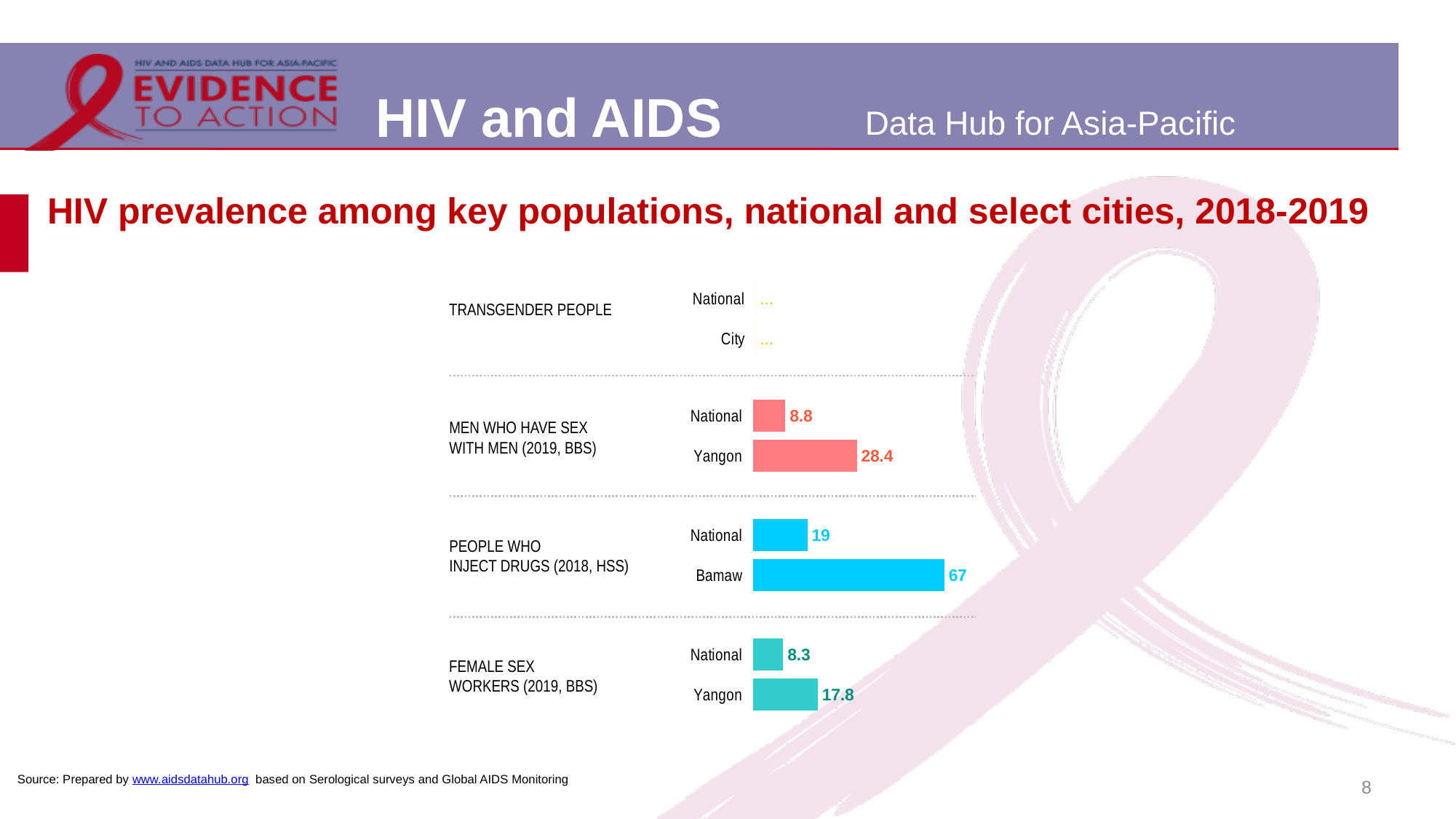
Which bar shows the highest HIV prevalence on the chart? People who inject drugs, Bamaw What is the national HIV prevalence among female sex workers (2019, BBS)? 8.3 What is the HIV prevalence among female sex workers in Yangon? 17.8 What kind of chart is shown on the slide? Bar chart What values are shown for transgender people (national and city)? ... (no data) What is the national HIV prevalence among men who have sex with men (2019, BBS)? 8.8 What is the HIV prevalence among men who have sex with men in Yangon? 28.4 What is the HIV prevalence among people who inject drugs in Bamaw? 67 What is the difference between the Bamaw and national HIV prevalence among people who inject drugs? 48 Which is larger: the Yangon value for men who have sex with men or the Yangon value for female sex workers? Men who have sex with men (28.4) Which of the printed values is the lowest on the chart? Female sex workers, National (8.3) What is the difference between the Yangon and national HIV prevalence among men who have sex with men? 19.6